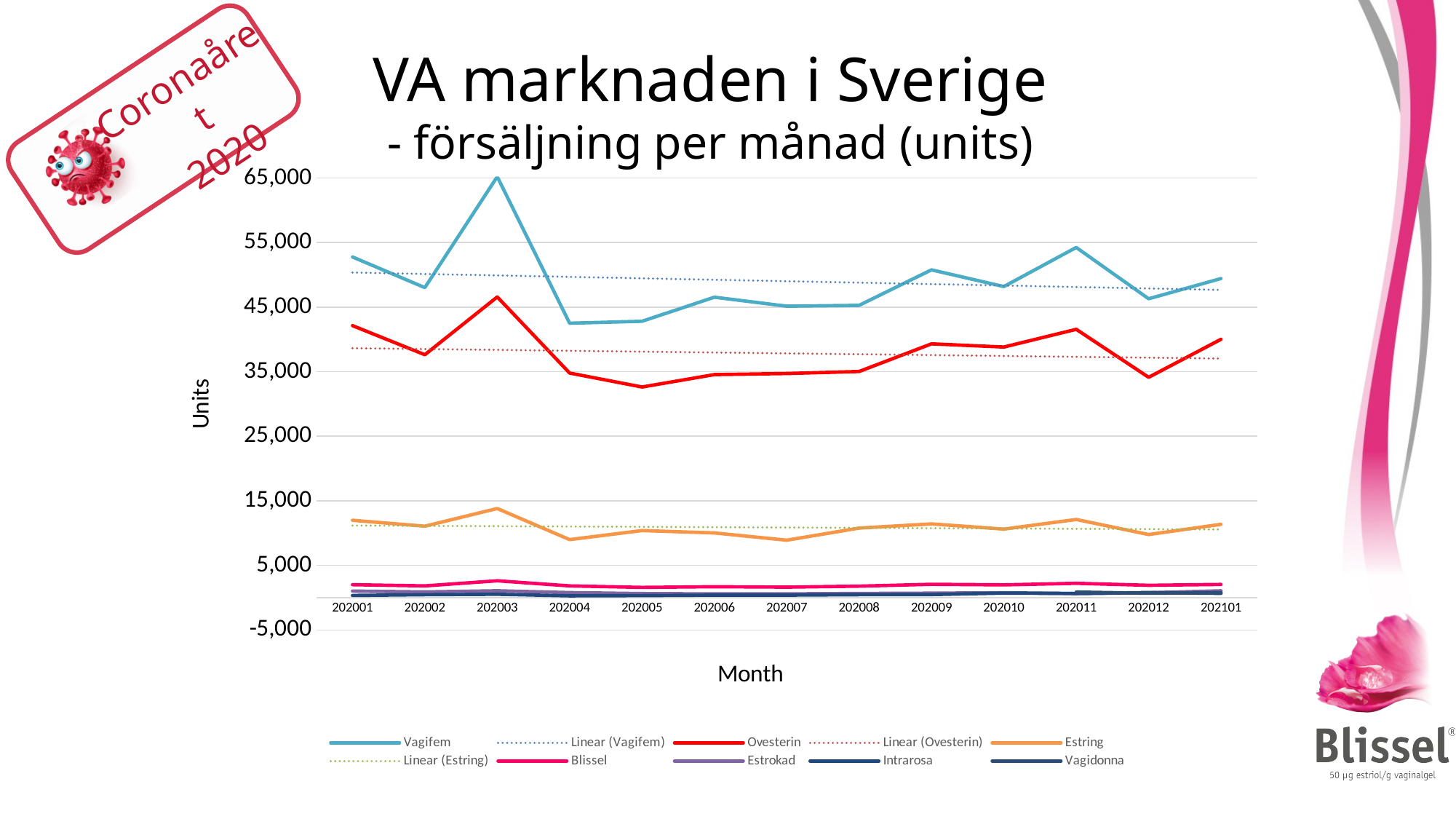
Which series has the higher value in 202001, Vagifem or Ovesterin? Vagifem What is the title of the vertical axis? Units Is the value for Vagifem in 202004 greater or less than 45,000? less Is the value for Estring in 202003 greater or less than 15,000? less Is the value for Ovesterin in 202005 greater or less than 35,000? less In which month does the Ovesterin line reach its lowest value? 202005 How many series does the legend list? 10 In which month does the Vagifem line reach its highest value? 202003 How many months are plotted along the x axis? 13 Does the Ovesterin line rise or fall from 202003 to 202005? fall What kind of chart is shown on the slide? line chart